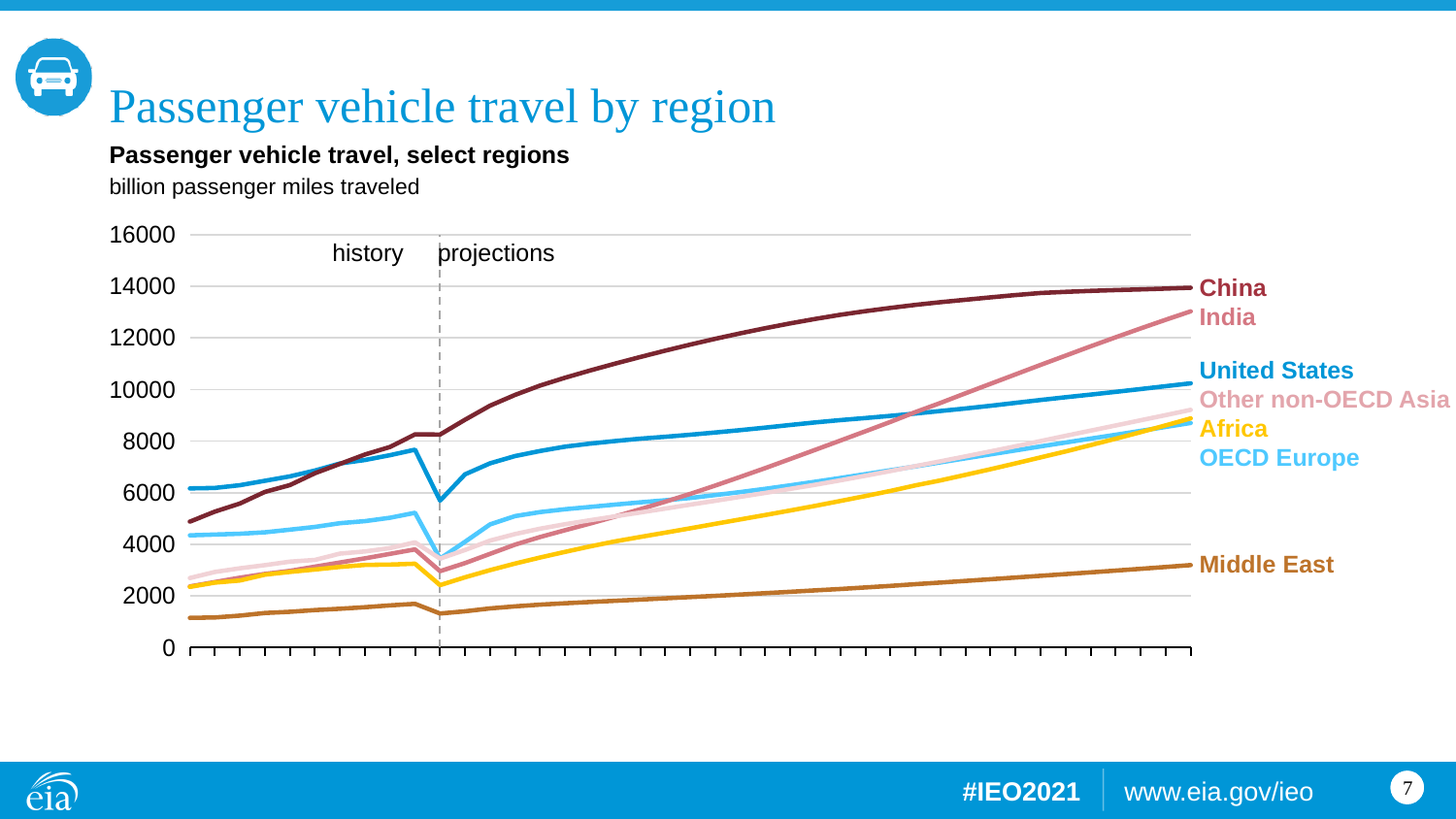
At the end of the projection period, is the value for Africa greater or less than 10000? less At the end of the projection period, which is larger: the value for India or the value for the United States? India Does the value for China generally rise or fall over the projection period? rise What kind of chart is shown on the slide? line chart At the end of the projection period, is the value for the United States greater or less than 8000? greater At the end of the projection period, is the value for China greater or less than 12000? greater Which region has the highest passenger vehicle travel at the end of the projection period? China Which region has the lowest passenger vehicle travel throughout the chart? Middle East What is the title of the chart? Passenger vehicle travel, select regions How many regions (series) are labeled on the chart? 7 What unit is the chart measured in? billion passenger miles traveled